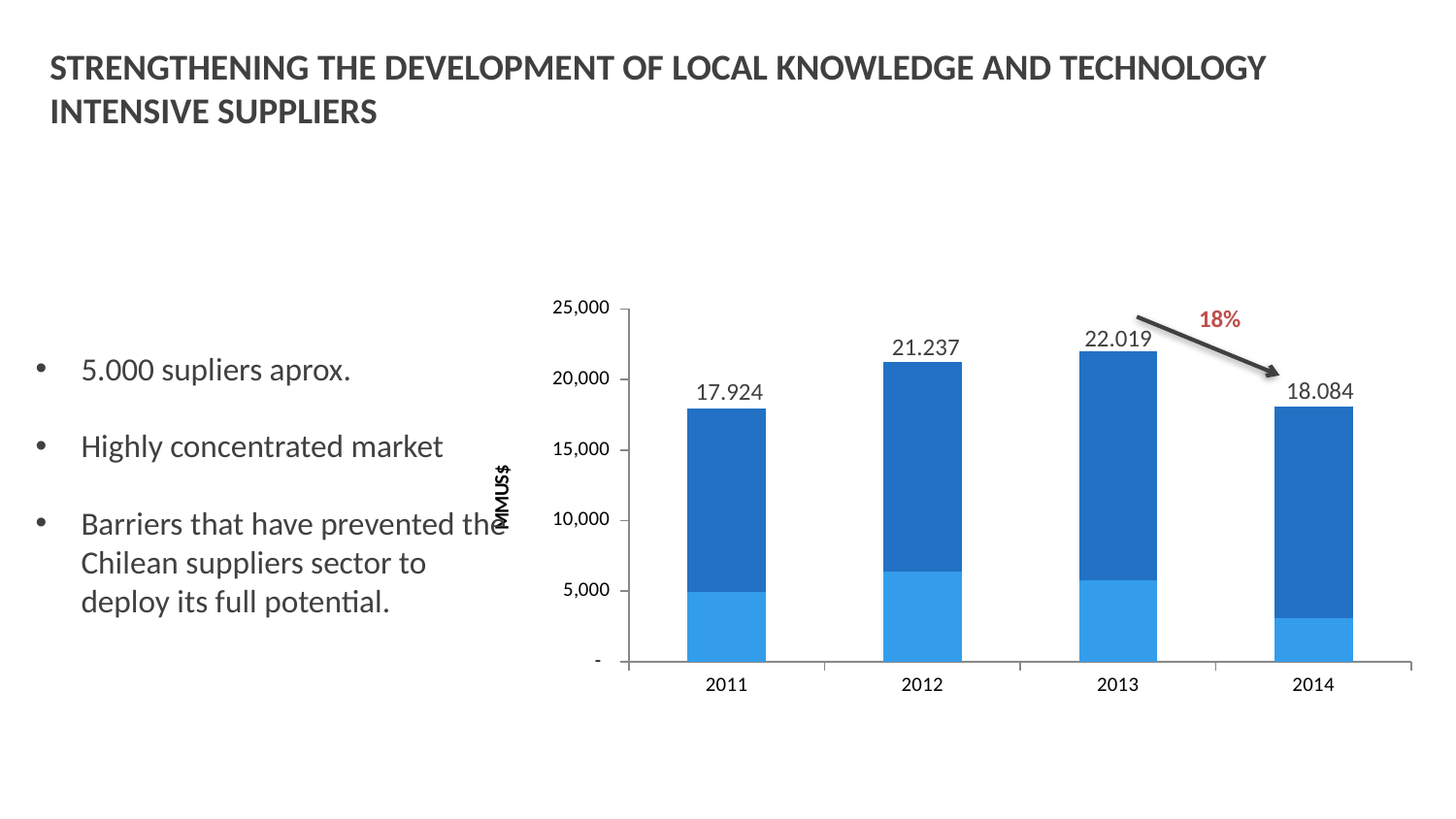
What is the label on the y axis of the chart? MMUS$ Which year has the highest total value? 2013 How many years are shown on the x axis? 4 What is the total value shown for 2014? 18.084 What is the difference between the total values for 2013 and 2014? 3.935 What is the total value shown for 2011? 17.924 Is the lower (light blue) segment of the 2014 bar greater or less than 5,000? less Which year has the larger total value, 2012 or 2014? 2012 What kind of chart is shown on the slide? Stacked bar chart Which year has the lowest total value? 2011 What is the total value shown for 2013? 22.019 How do the total values change from 2011 to 2014? They rise from 2011 to 2013, then fall in 2014